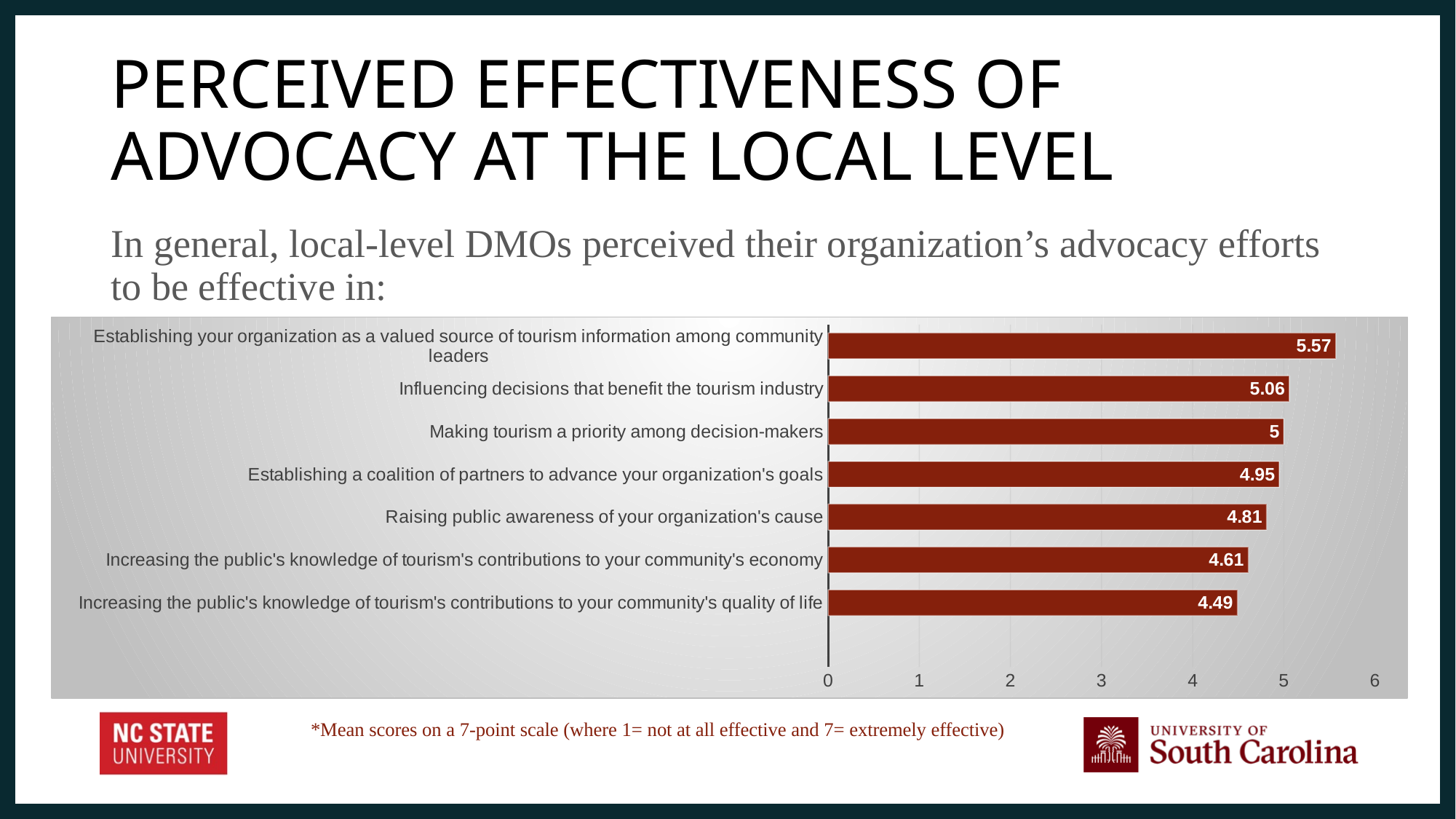
What is the difference between the highest score (5.57) and the lowest score (4.49)? 1.08 What kind of chart is shown on the slide? Bar chart What is the difference between the scores for "Establishing a coalition of partners to advance your organization's goals" and "Increasing the public's knowledge of tourism's contributions to your community's economy"? 0.34 Which category has the lowest mean score? Increasing the public's knowledge of tourism's contributions to your community's quality of life What is the mean score for "Making tourism a priority among decision-makers"? 5 Is the value for "Increasing the public's knowledge of tourism's contributions to your community's economy" greater or less than 5? less Which has a higher score: "Influencing decisions that benefit the tourism industry" or "Raising public awareness of your organization's cause"? Influencing decisions that benefit the tourism industry What is the maximum value shown on the x axis of the chart? 6 What is the mean score for "Raising public awareness of your organization's cause"? 4.81 Which category has the highest mean score? Establishing your organization as a valued source of tourism information among community leaders How many categories are shown in the chart? 7 What is the mean score for "Influencing decisions that benefit the tourism industry"? 5.06